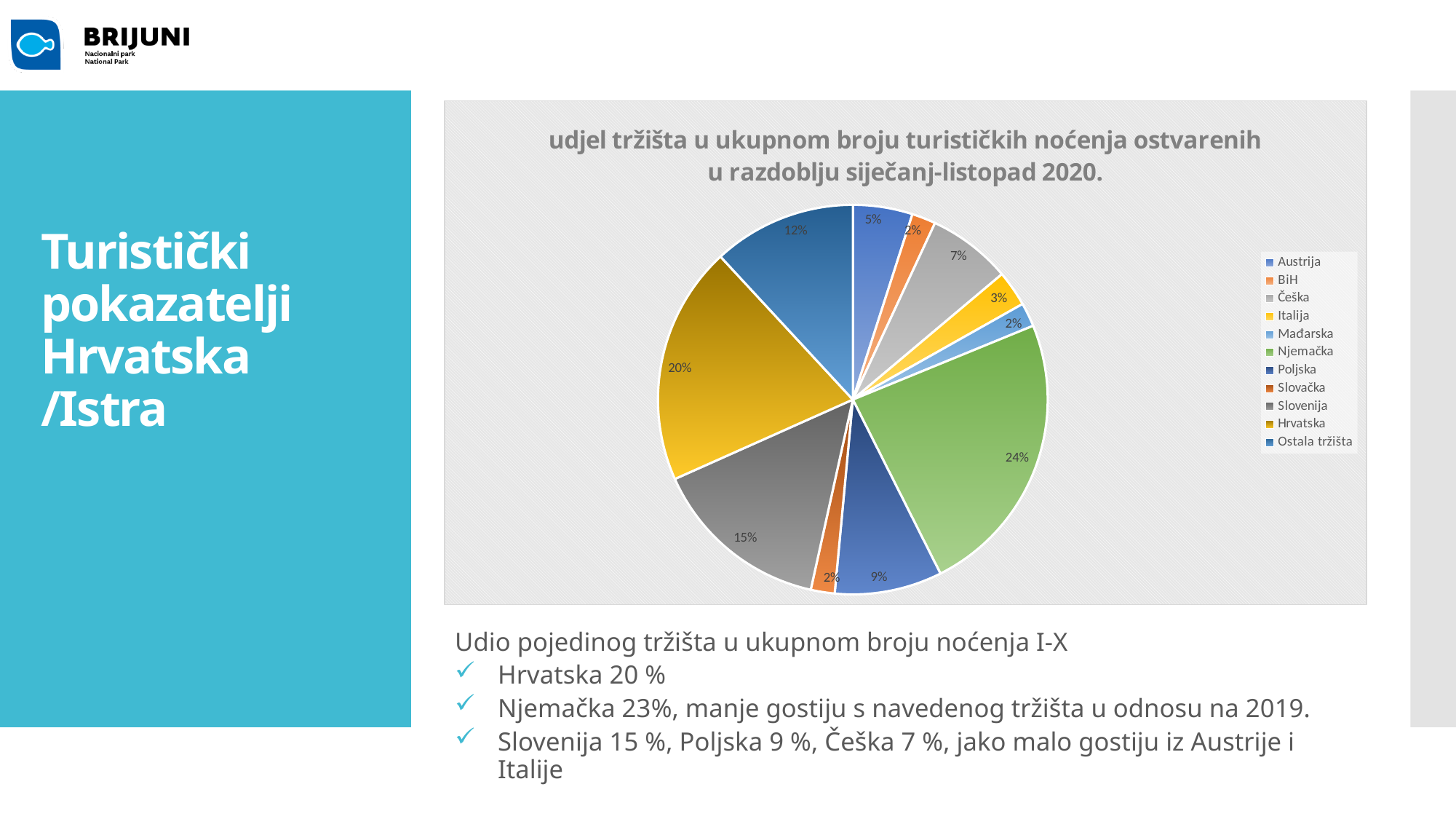
What share of the pie does Ostala tržišta have? 12% Which market has the largest slice of the pie? Njemačka What share of the pie does Češka have? 7% What share of the pie does Hrvatska have? 20% Which slice is larger, Hrvatska or Njemačka? Njemačka What share of the pie does Slovenija have? 15% What share of the pie does Njemačka have? 24% What is the title of the chart? udjel tržišta u ukupnom broju turističkih noćenja ostvarenih u razdoblju siječanj-listopad 2020. What kind of chart is shown on the slide? pie chart By how many percentage points does Njemačka's share exceed Hrvatska's share? 4 What share of the pie does Poljska have? 9% How many markets does the legend list? 11